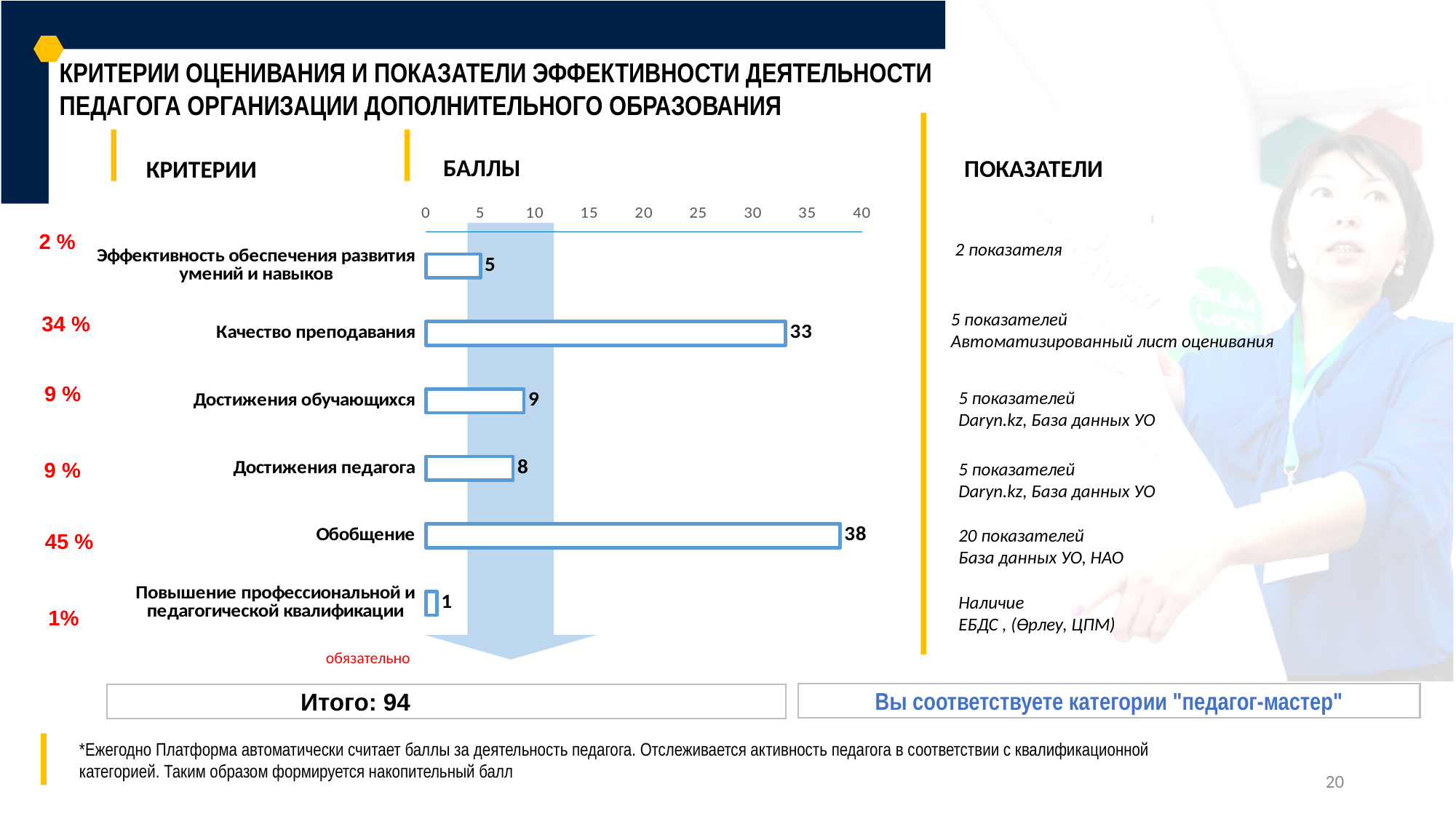
What is the highest tick value shown on the chart's axis? 40 Which category has the highest value? Обобщение What is the difference between the values for Обобщение and Качество преподавания? 5 What is the value for Качество преподавания? 33 What is the value for Обобщение? 38 Is the value for Качество преподавания greater or less than 30? greater Which is larger, the value for Достижения обучающихся or the value for Достижения педагога? Достижения обучающихся What is the value for Повышение профессиональной и педагогической квалификации? 1 Which category has the lowest value? Повышение профессиональной и педагогической квалификации What is the value for Достижения обучающихся? 9 What kind of chart is shown on the slide? bar chart How many categories does the bar chart show? 6